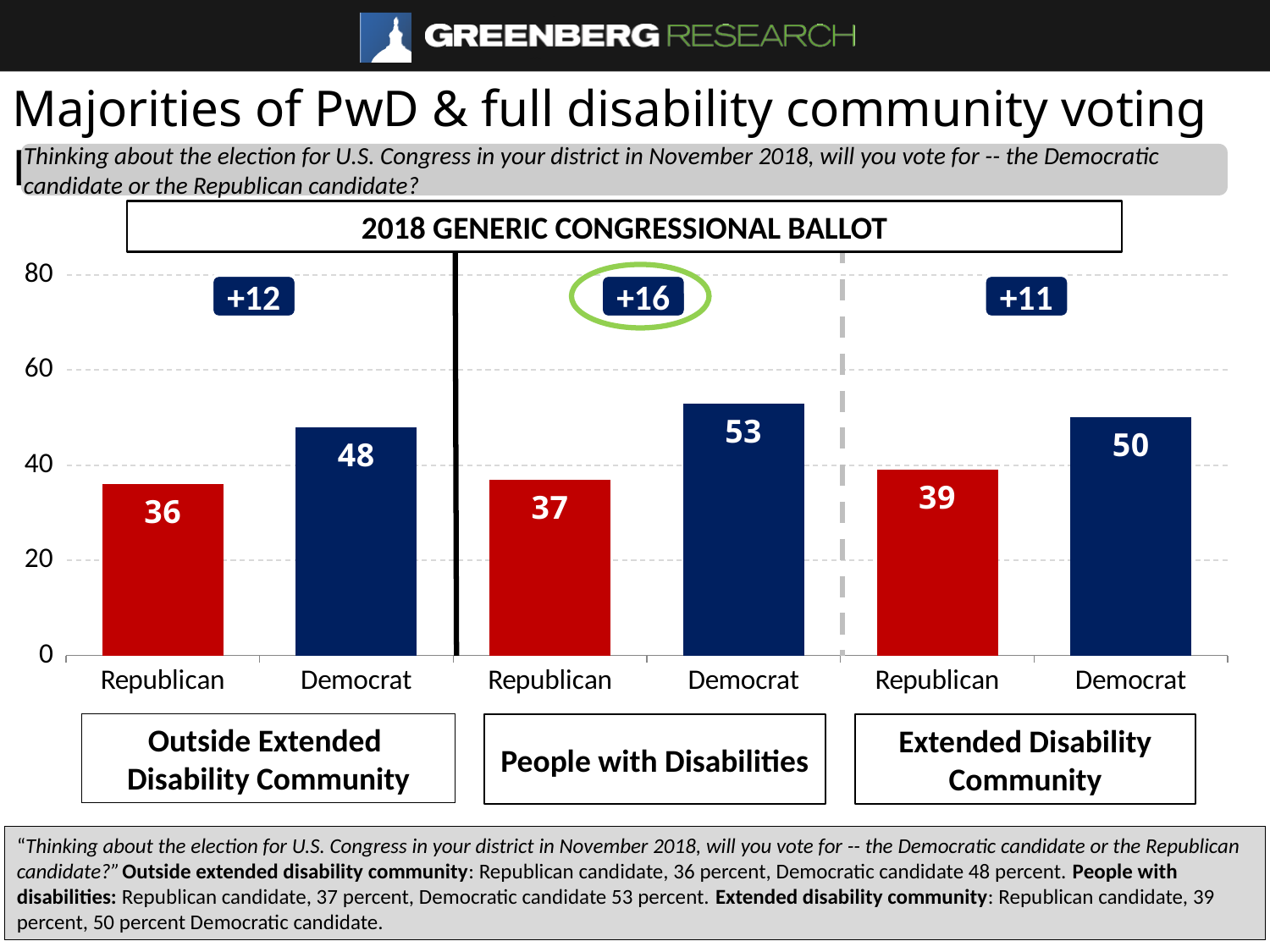
What is the value for Republican among People with Disabilities? 37 Which is larger: the Republican value for People with Disabilities or the Republican value for the Extended Disability Community? Extended Disability Community What is the title of the chart? 2018 GENERIC CONGRESSIONAL BALLOT Is the Democrat value for the Outside Extended Disability Community greater or less than 40? greater What is the value for Democrat among People with Disabilities? 53 What kind of chart is shown on the slide? bar chart What is the difference between the Democrat and Republican values in the Extended Disability Community group? 11 What is the value for Democrat in the Extended Disability Community group? 50 Which bar has the lowest value on the chart? Republican, Outside Extended Disability Community How many bars are plotted on the chart? 6 Which bar has the highest value on the chart? Democrat, People with Disabilities What is the value for Republican in the Outside Extended Disability Community group? 36